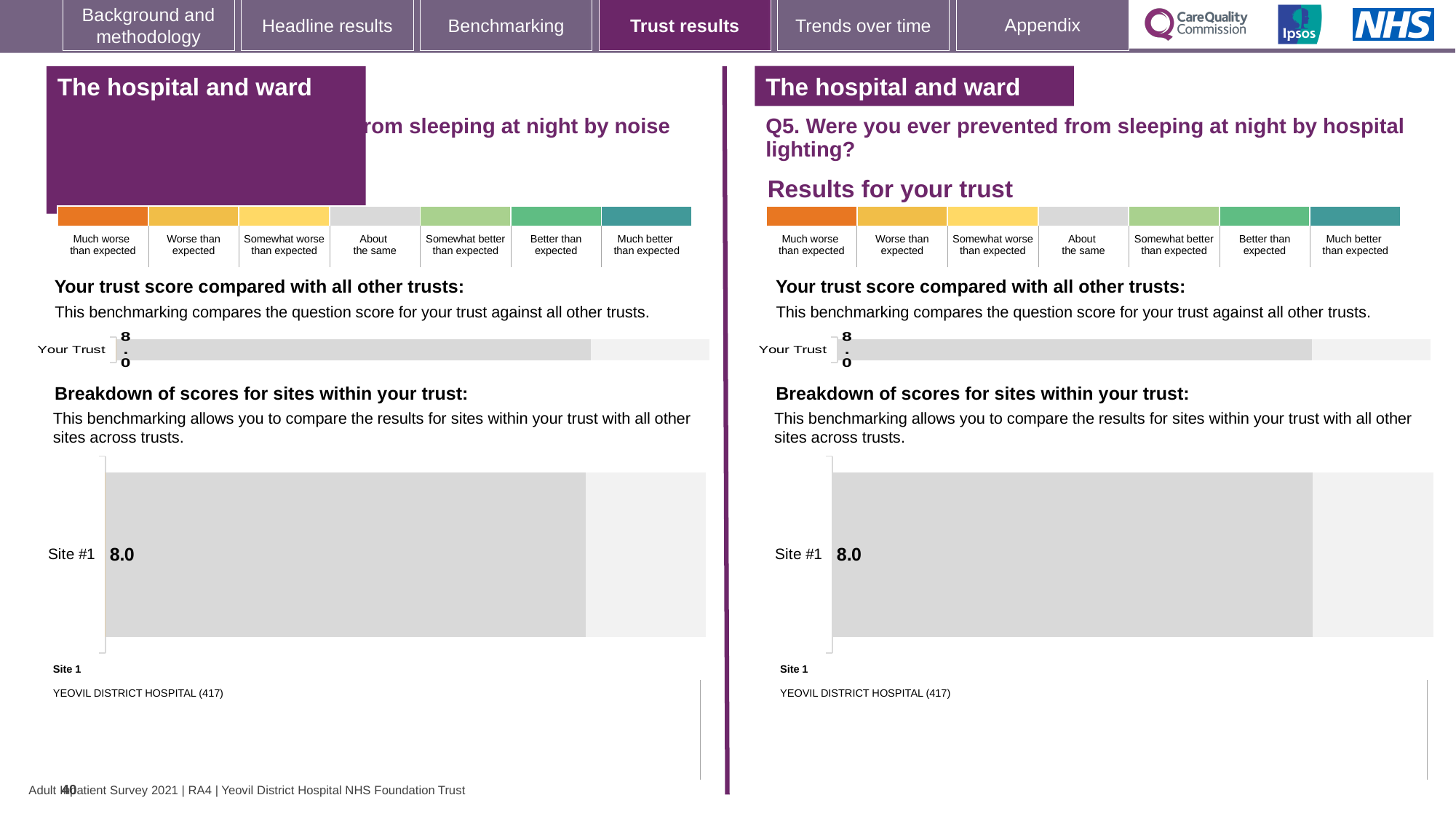
What kind of chart is used for the 'Breakdown of scores for sites within your trust' on the right half of the slide? Bar chart On the right half of the slide (Q5, hospital lighting), what score is shown for Your Trust in the 'Your trust score compared with all other trusts' chart? 8.0 On the left half of the slide (sleeping at night by noise), what score is shown for Your Trust in the 'Your trust score compared with all other trusts' chart? 8.0 Which site name is listed as Site 1 below the breakdown chart on the right half of the slide? YEOVIL DISTRICT HOSPITAL (417) What is the category label on the bar in the 'Your trust score compared with all other trusts' chart on the left half of the slide? Your Trust On the right half of the slide (Q5, hospital lighting), what score is shown for Site #1 in the 'Breakdown of scores for sites within your trust' chart? 8.0 On the left half of the slide (sleeping at night by noise), what score is shown for Site #1 in the 'Breakdown of scores for sites within your trust' chart? 8.0 How many sites are plotted in the 'Breakdown of scores for sites within your trust' chart on the left half of the slide? 1 How many sites are plotted in the 'Breakdown of scores for sites within your trust' chart on the right half of the slide? 1 What is the difference between the Site #1 score and the Your Trust score on the right half of the slide (Q5, hospital lighting)? 0.0